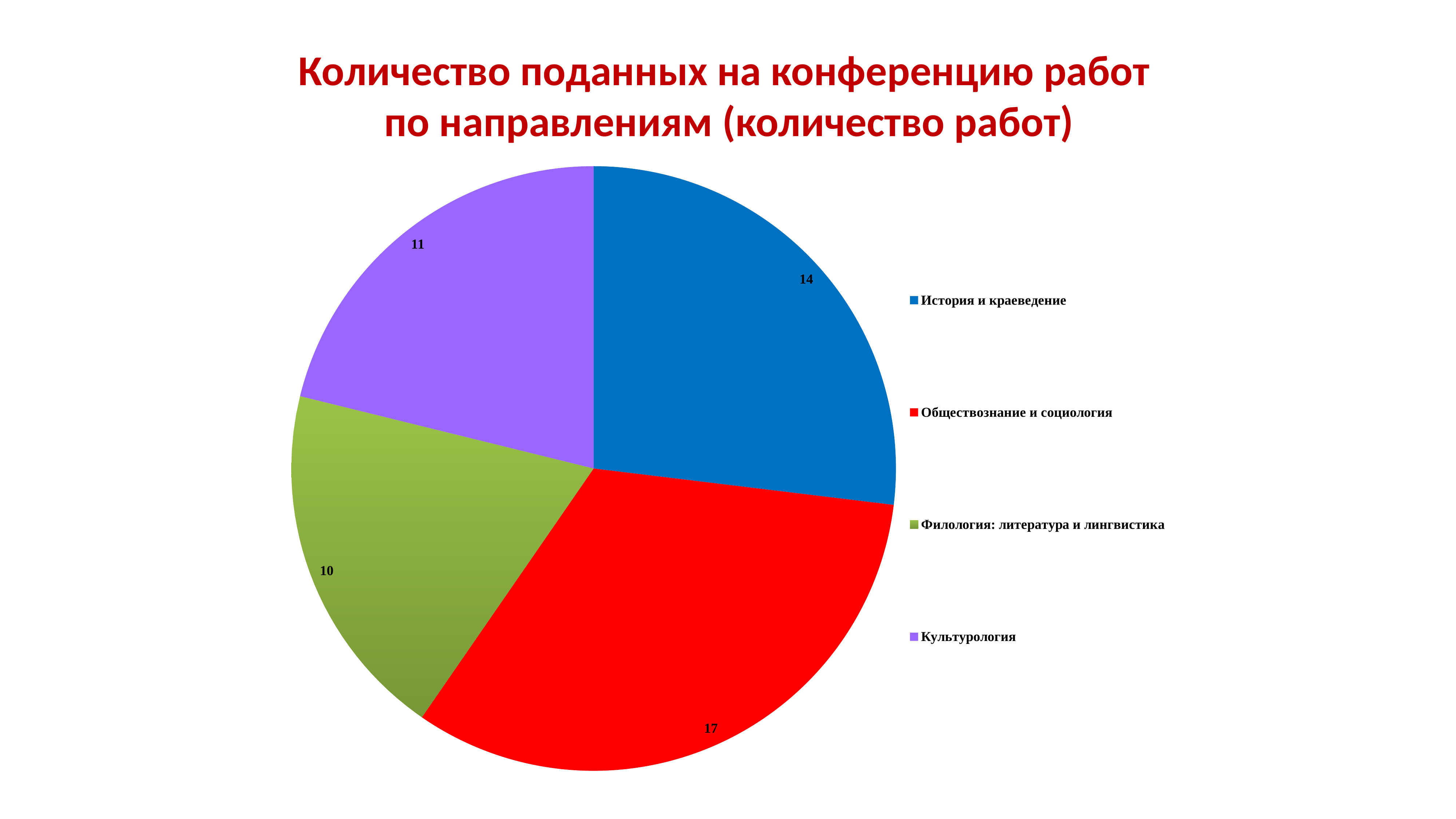
How many works were submitted in the category Культурология? 11 How many categories are shown in the pie chart? 4 How many works were submitted in the category Филология: литература и лингвистика? 10 Which category has more submitted works: Культурология or Филология: литература и лингвистика? Культурология Which category has the largest number of submitted works? Обществознание и социология What is the total number of works across all four categories? 52 What kind of chart is shown on the slide? Pie chart How many works were submitted in the category Обществознание и социология? 17 Which category has the smallest number of submitted works? Филология: литература и лингвистика Which colour represents Культурология in the pie chart? Purple What is the difference between the number of works in Обществознание и социология and in История и краеведение? 3 How many works were submitted in the category История и краеведение? 14